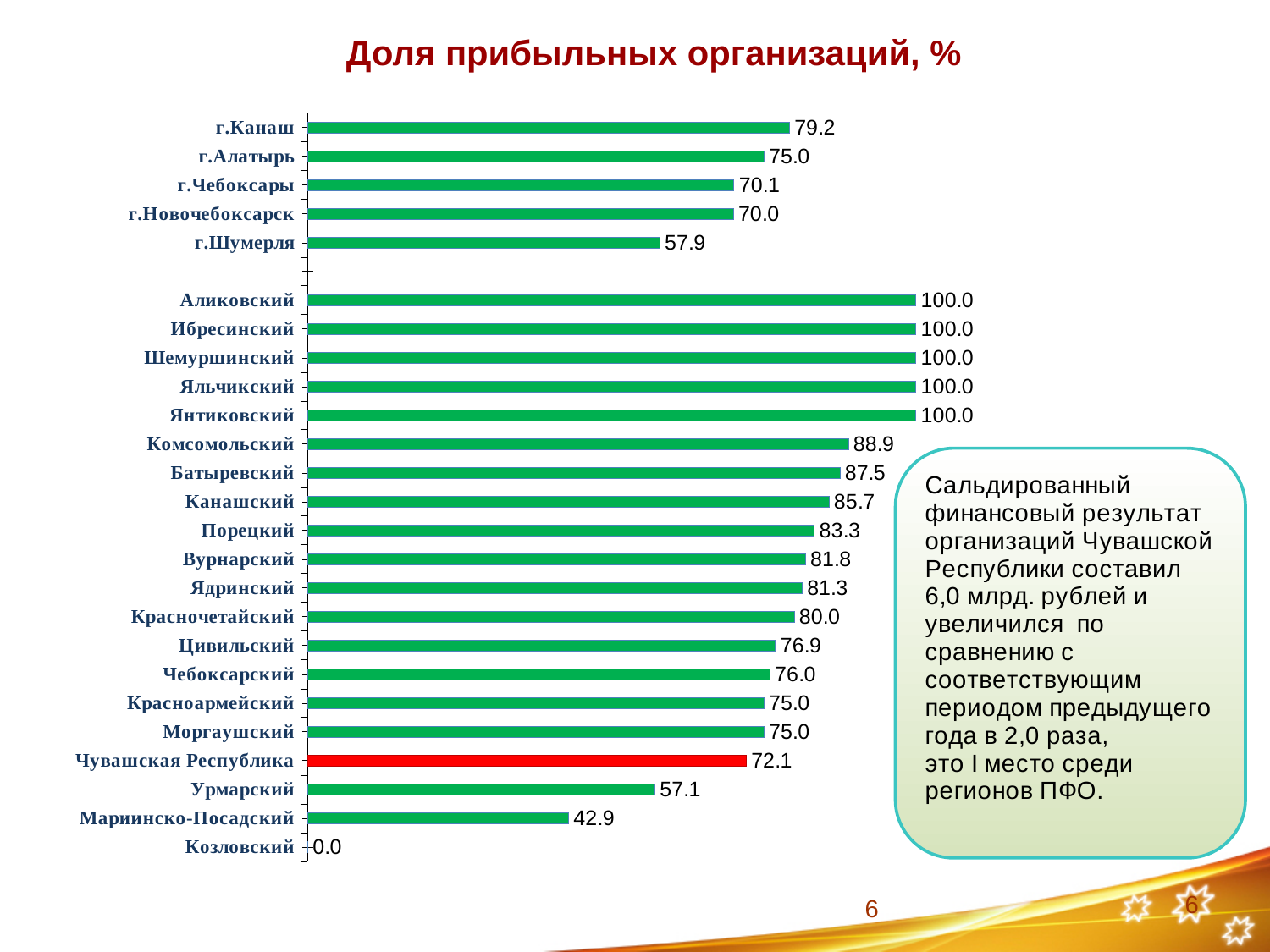
What is the value for г.Канаш? 79.2 What is the value for Комсомольский? 88.9 What is the difference between the values for г.Канаш and г.Шумерля? 21.3 What is the difference between the values for Батыревский and Канашский? 1.8 What kind of chart is shown on the slide? Bar chart What is the value for Чувашская Республика? 72.1 What is the value for Мариинско-Посадский? 42.9 Which is larger, the value for Урмарский or the value for г.Шумерля? г.Шумерля Which category has the lowest value? Козловский How many categories are plotted on the chart? 25 Which bar is coloured red instead of green? Чувашская Республика Among the cities (г.Канаш, г.Алатырь, г.Чебоксары, г.Новочебоксарск, г.Шумерля), which has the highest value? г.Канаш